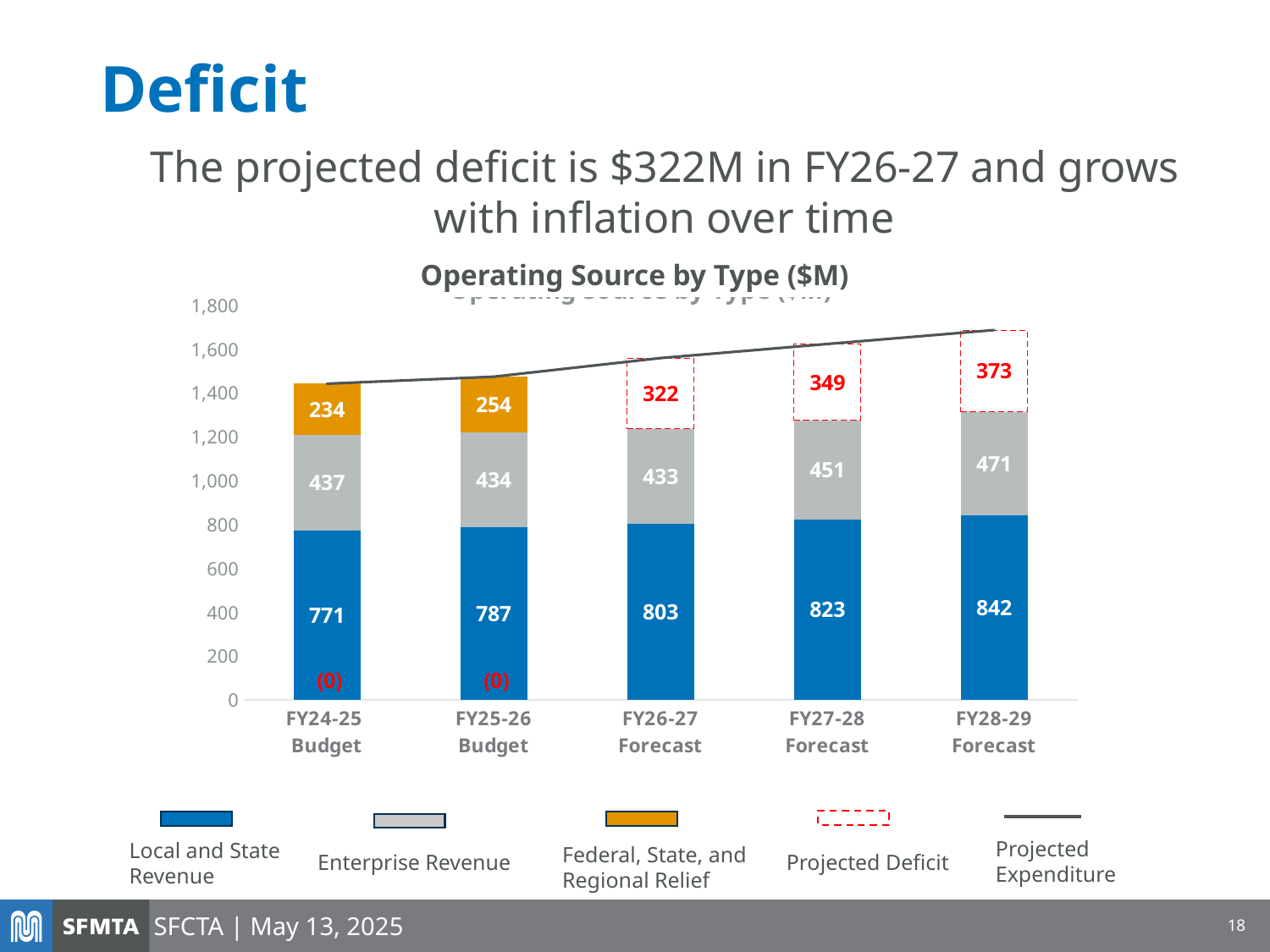
What is the Federal, State, and Regional Relief value for FY25-26 Budget? 254 What is the Projected Deficit for FY28-29 Forecast? 373 How many entries does the legend list? 5 Which is larger: Federal, State, and Regional Relief in FY24-25 Budget or in FY25-26 Budget? FY25-26 Budget What is the Enterprise Revenue value for FY27-28 Forecast? 451 What is the Local and State Revenue value for FY26-27 Forecast? 803 How many fiscal year categories are shown on the x axis? 5 Which fiscal year has the lowest Enterprise Revenue? FY26-27 Forecast Which fiscal year has the highest Local and State Revenue? FY28-29 Forecast Does Local and State Revenue rise or fall from FY24-25 Budget to FY28-29 Forecast? Rise What is the difference between the Projected Deficit in FY27-28 Forecast and FY26-27 Forecast? 27 What kind of chart is used to show the operating sources? Stacked bar chart with a line